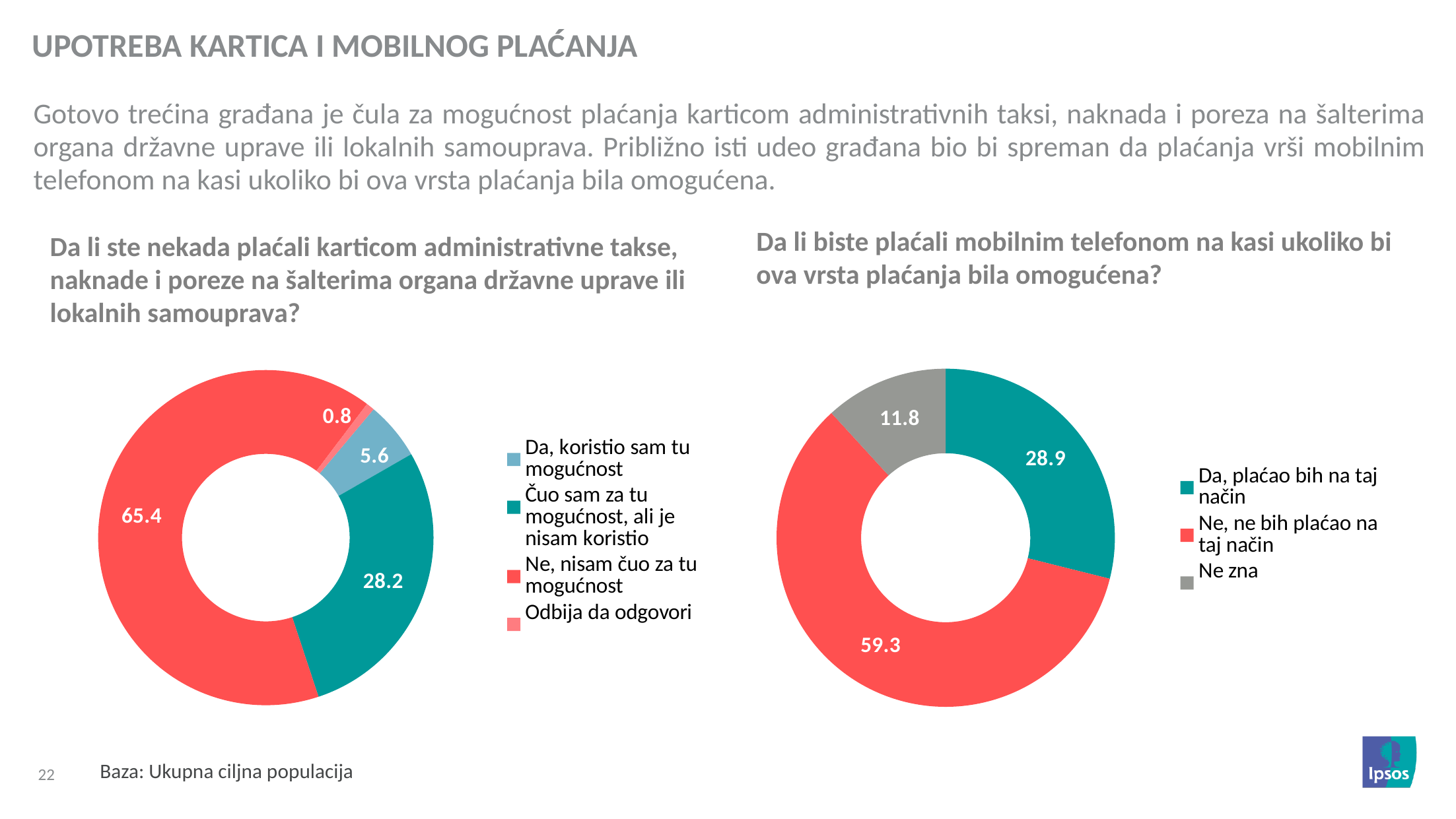
In the left chart (card payment of administrative fees), which category has the lowest value? Odbija da odgovori In the left chart (card payment of administrative fees), what is the value for 'Da, koristio sam tu mogućnost'? 5.6 In the left chart (card payment of administrative fees), what is the value for 'Ne, nisam čuo za tu mogućnost'? 65.4 In the right chart (mobile phone payment), what is the value for 'Ne zna'? 11.8 What type of chart is the right chart (mobile phone payment)? Doughnut chart In the right chart (mobile phone payment), what is the difference between 'Ne, ne bih plaćao na taj način' and 'Da, plaćao bih na taj način'? 30.4 How many categories does the legend of the right chart (mobile phone payment) list? 3 In the left chart (card payment of administrative fees), which is larger: 'Čuo sam za tu mogućnost, ali je nisam koristio' or 'Da, koristio sam tu mogućnost'? Čuo sam za tu mogućnost, ali je nisam koristio In the right chart (mobile phone payment), which category has the highest value? Ne, ne bih plaćao na taj način How many categories does the legend of the left chart (card payment of administrative fees) list? 4 In the left chart (card payment of administrative fees), what is the value for 'Odbija da odgovori'? 0.8 In the right chart (mobile phone payment), what colour is the 'Ne zna' slice? Grey